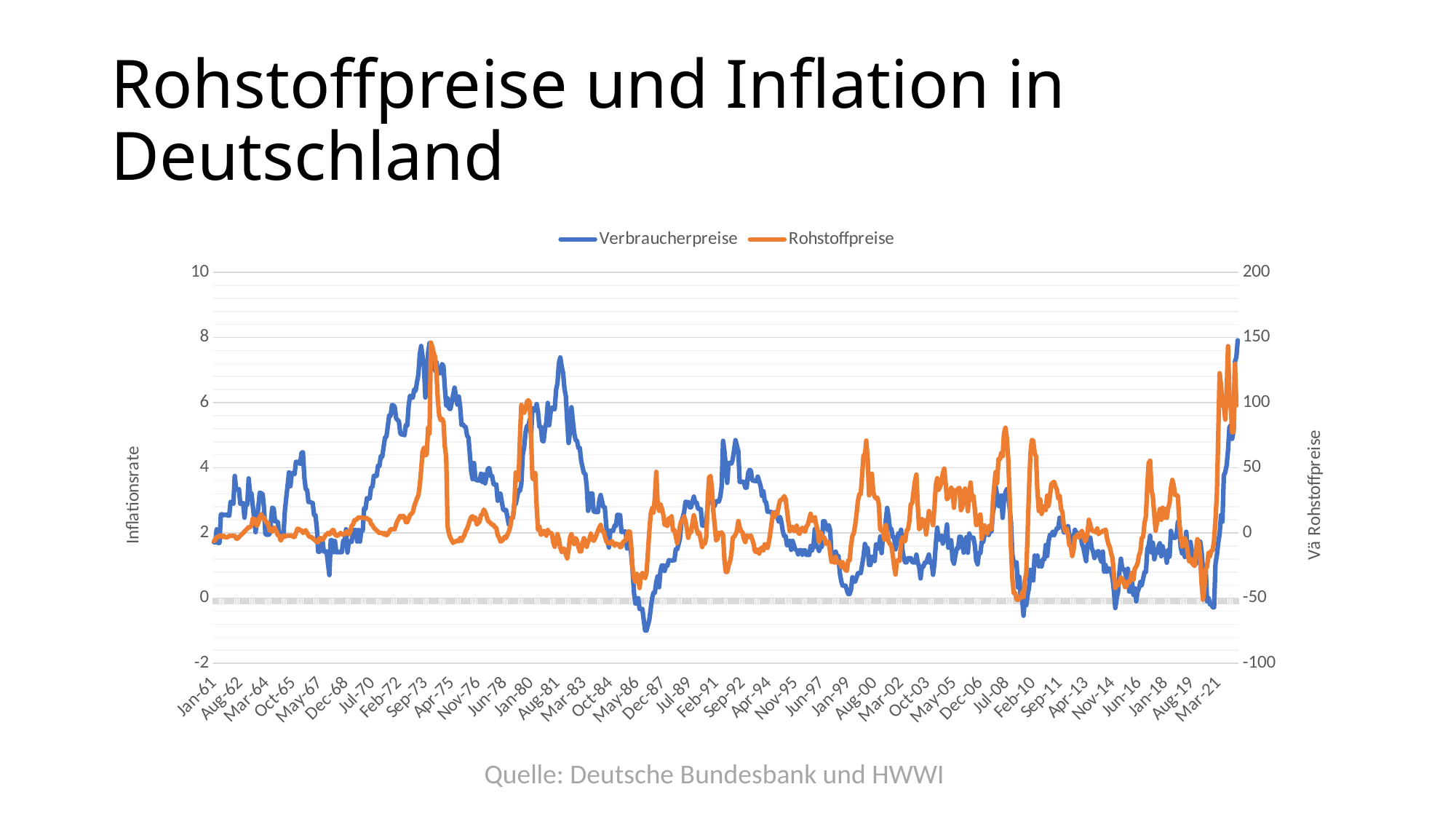
Is the value of Rohstoffpreise around Jan-80 greater or less than 50 on the right axis? greater What kind of chart is shown on the slide? line chart Is the value of Verbraucherpreise around Jan-99 greater or less than 2? less How many series does the legend list? 2 What is the label of the right-hand vertical axis? Vä Rohstoffpreise Is the value of Verbraucherpreise around Sep-73 greater or less than 6? greater Does the Rohstoffpreise line rise or fall from Sep-73 to Apr-75? fall Which two series are listed in the legend? Verbraucherpreise and Rohstoffpreise Does the Verbraucherpreise line rise or fall from Mar-21 to the right end of the chart? rise